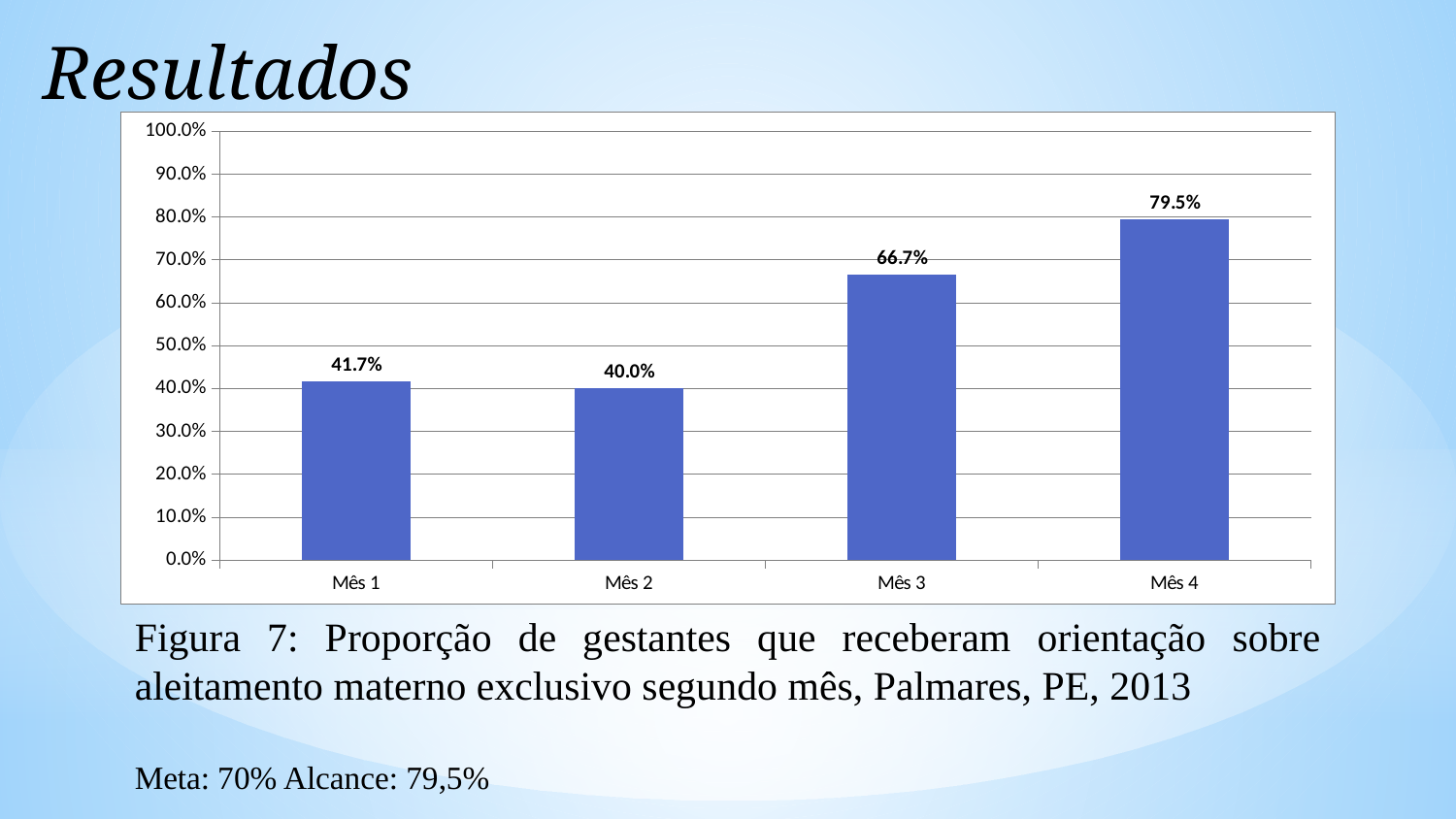
What is the value for Mês 3? 66.7% What is the difference between the values for Mês 4 and Mês 3? 12.8% What is the difference between the values for Mês 1 and Mês 2? 1.7% Which month has the highest value? Mês 4 How many months are shown on the x axis? 4 Is the value for Mês 3 greater or less than 60.0%? greater What is the value for Mês 1? 41.7% What kind of chart is shown on the slide? bar chart Which month has the lowest value? Mês 2 Which is larger, the value for Mês 3 or the value for Mês 1? Mês 3 What is the value for Mês 2? 40.0% What is the value for Mês 4? 79.5%